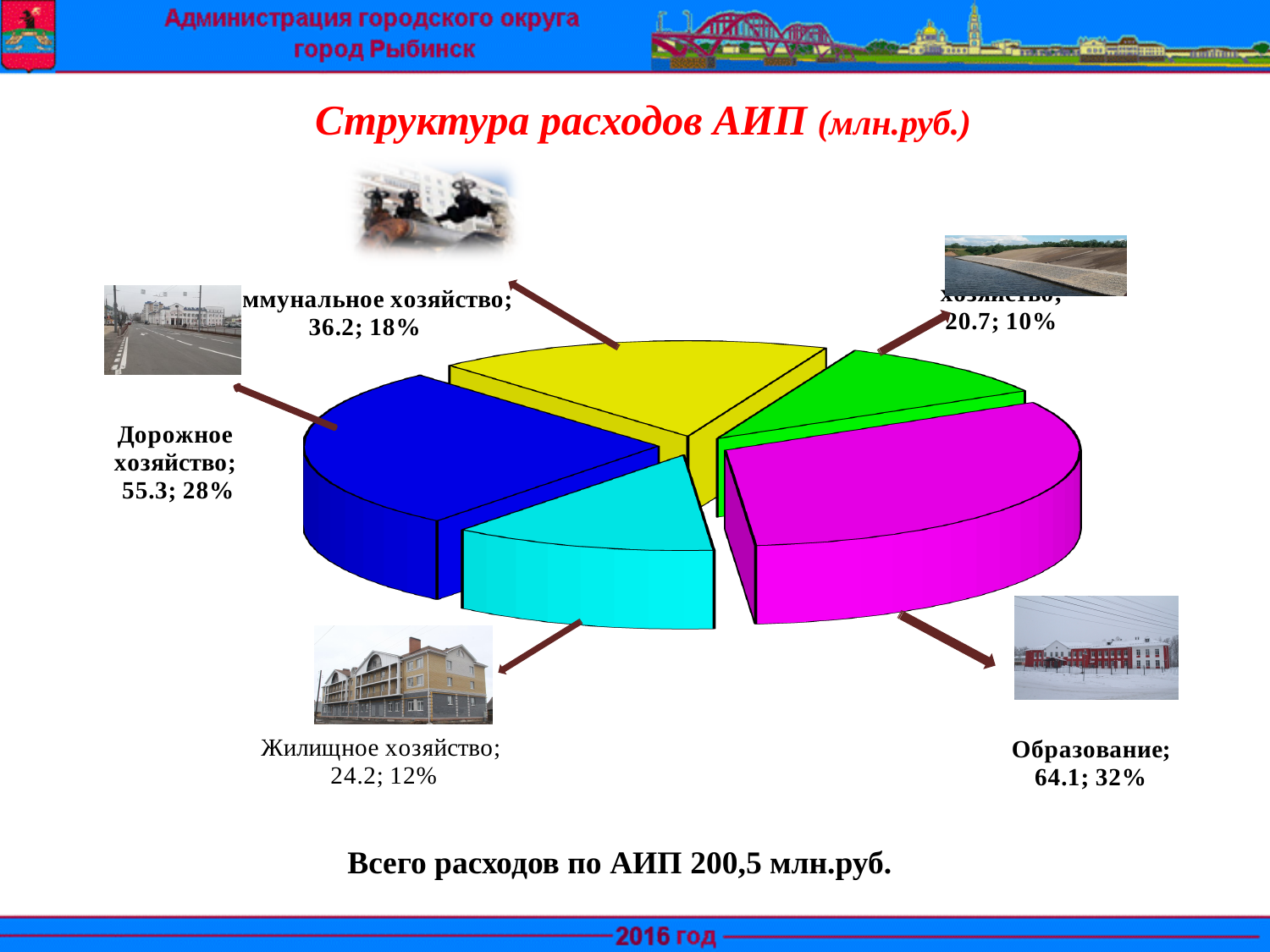
What is the value for Дорожное хозяйство? 55.3 What share of the pie does Жилищное хозяйство take? 12% What is the title of the chart? Структура расходов АИП (млн.руб.) Which category has the largest slice? Образование What is the value for Жилищное хозяйство? 24.2 What is the smallest percentage shown on the chart? 10% What is the difference between the values for Образование and Дорожное хозяйство? 8.8 What kind of chart is shown on the slide? pie chart What is the value for Образование? 64.1 Which is larger, the value for Коммунальное хозяйство or for Жилищное хозяйство? Коммунальное хозяйство What share of the pie does Образование take? 32% How many slices does the pie chart have? 5